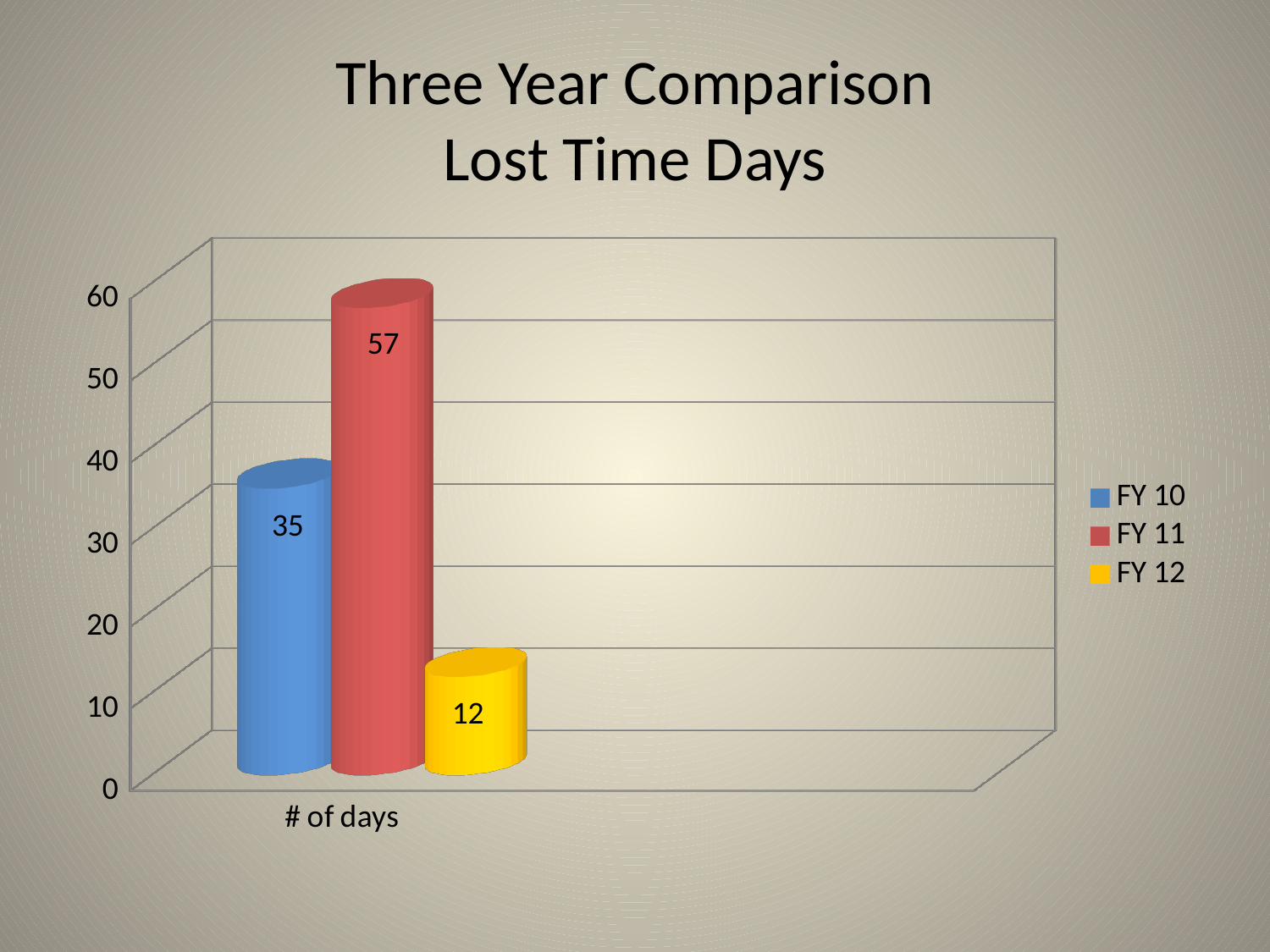
What is the value for FY 12? 12 What colour is the bar for FY 12? Yellow How many series does the legend list? 3 What is the value for FY 11? 57 Which fiscal year has the lowest number of lost time days? FY 12 Which fiscal year has the highest number of lost time days? FY 11 What is the difference between the FY 10 and FY 12 values? 23 What is the difference between the FY 11 and FY 10 values? 22 What is the value for FY 10? 35 What kind of chart is shown on the slide? Bar chart What is the title of the chart? Three Year Comparison Lost Time Days Which is larger, the value for FY 10 or the value for FY 12? FY 10